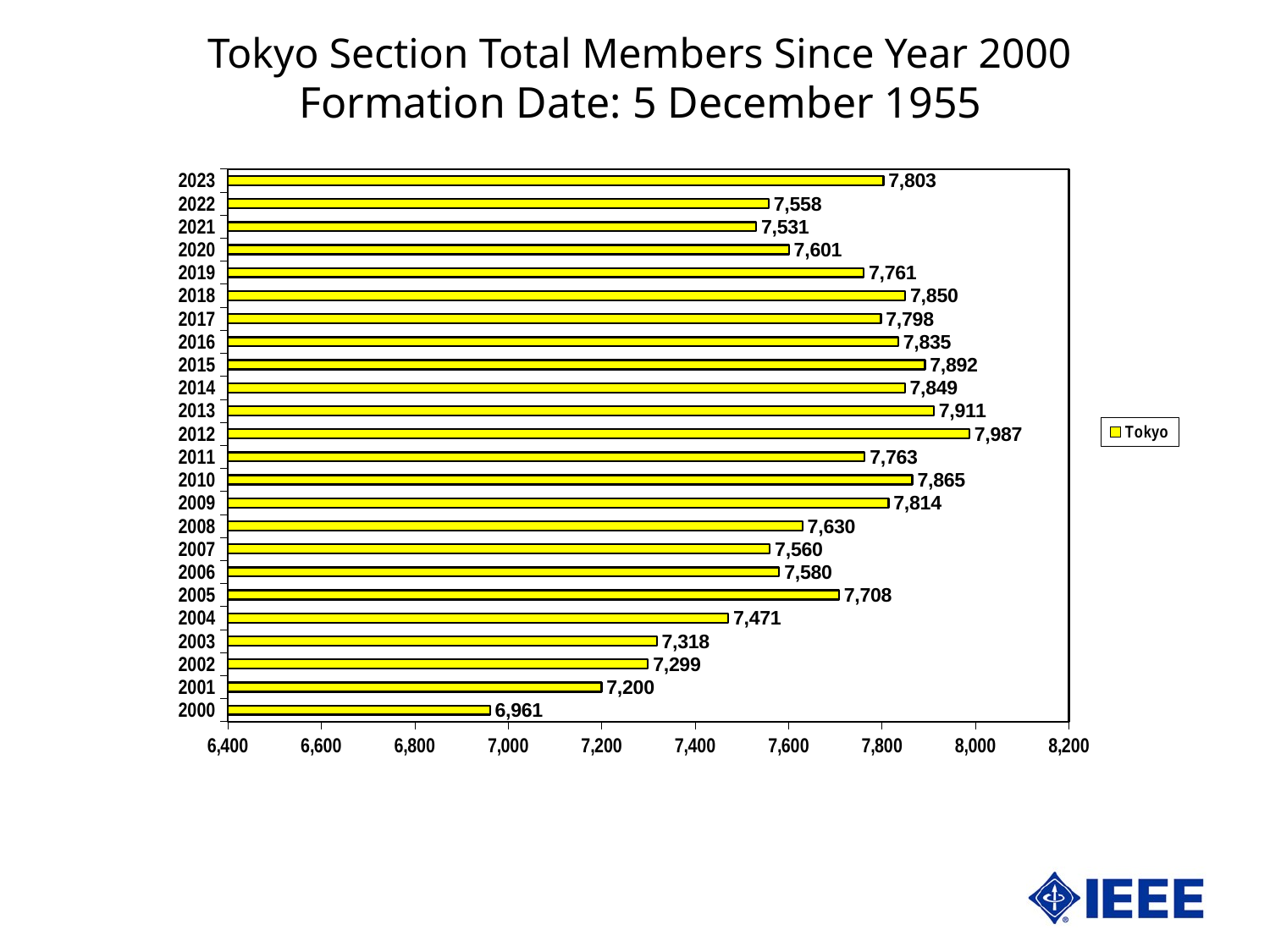
What is the difference in membership between 2012 and 2000? 1,026 Which year had the highest Tokyo Section membership? 2012 What series name is listed in the chart legend? Tokyo Is the membership value for 2004 greater or less than 7,400? greater What was the Tokyo Section total membership in 2023? 7,803 Which year had the lowest Tokyo Section membership? 2000 Which year had more members, 2019 or 2020? 2019 What kind of chart is shown on the slide? Bar chart What was the Tokyo Section total membership in 2012? 7,987 What was the Tokyo Section total membership in 2000? 6,961 What is the difference in membership between 2023 and 2022? 245 How many years are shown in the chart? 24